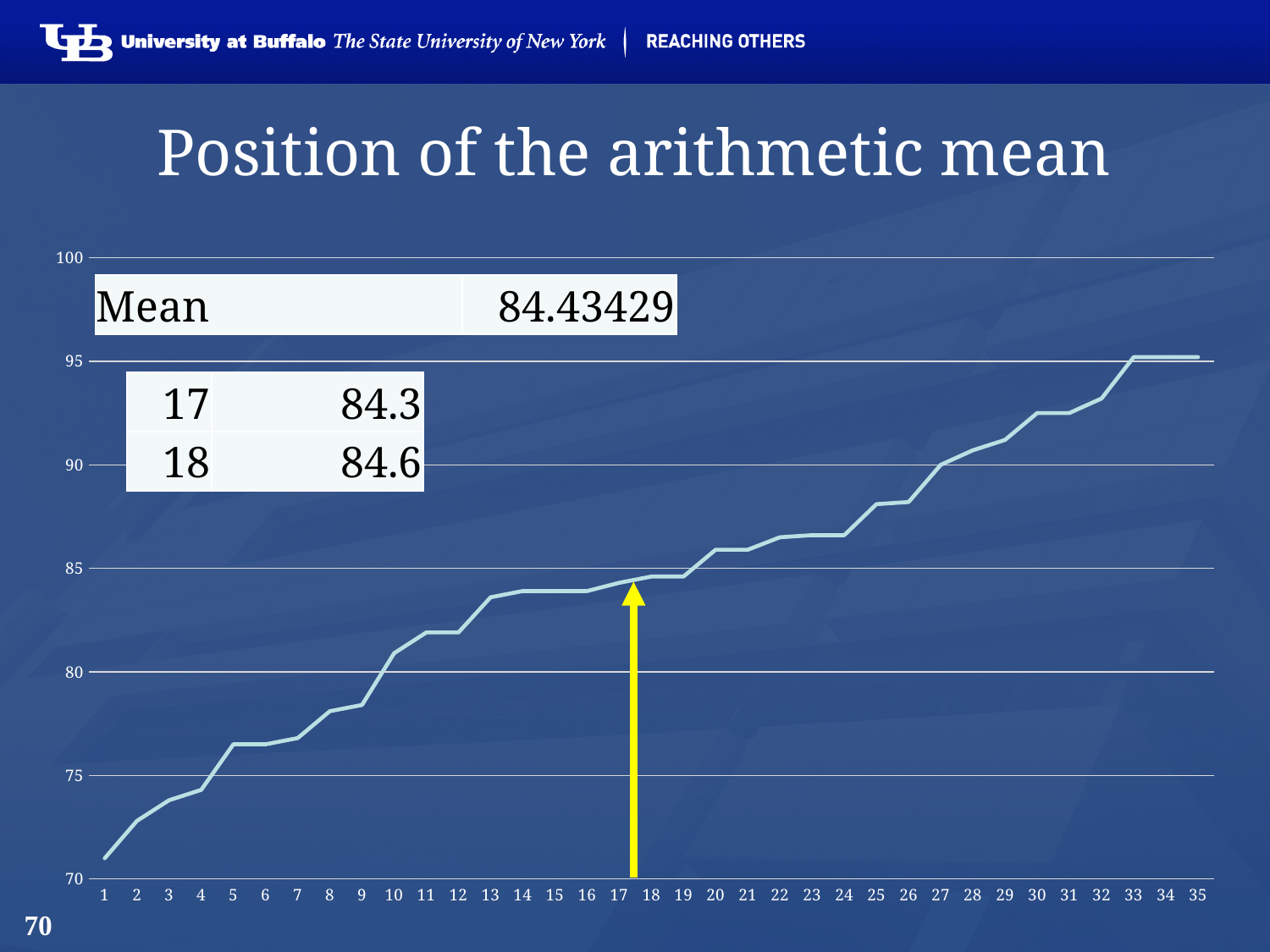
Is the value at position 1 greater or less than 75? less What value is listed for position 17 in the table on the chart? 84.3 What is the difference between the values listed for positions 18 and 17? 0.3 Is the value at position 25 greater or less than 85? greater What kind of chart is shown on the slide? line chart What value is listed for position 18 in the table on the chart? 84.6 Which x-axis position has the lowest plotted value? 1 Do the plotted values rise or fall as the x axis goes from 1 to 35? rise What mean value is shown in the table on the chart? 84.43429 Which is larger, the value listed for position 17 or for position 18? 18 Is the value at position 35 greater or less than 90? greater How many points are plotted along the x axis of the chart? 35